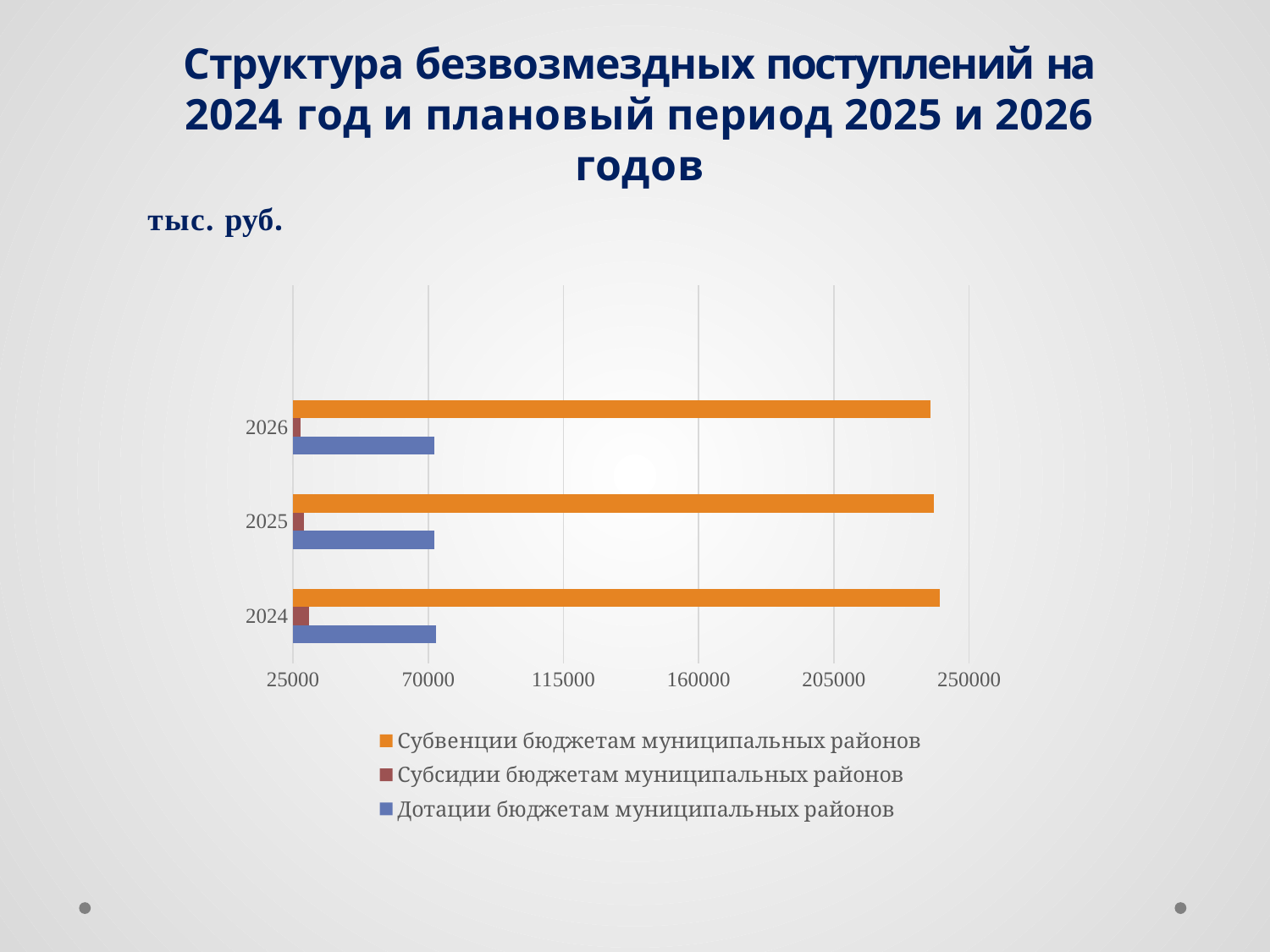
In 2025, which is larger: Дотации бюджетам муниципальных районов or Субсидии бюджетам муниципальных районов? Дотации бюджетам муниципальных районов Is the value for Субвенции бюджетам муниципальных районов in 2026 greater or less than 160000? greater What unit of measurement is indicated above the chart? тыс. руб. How many years (categories) are shown on the chart? 3 What kind of chart is shown on the slide? bar chart Is the value for Субсидии бюджетам муниципальных районов in 2025 greater or less than 70000? less How many series does the legend list? 3 Is the value for Субвенции бюджетам муниципальных районов in 2024 greater or less than 205000? greater What colour are the bars for Субвенции бюджетам муниципальных районов? orange Which series has the highest value for 2024? Субвенции бюджетам муниципальных районов Which series has the lowest value for 2026? Субсидии бюджетам муниципальных районов